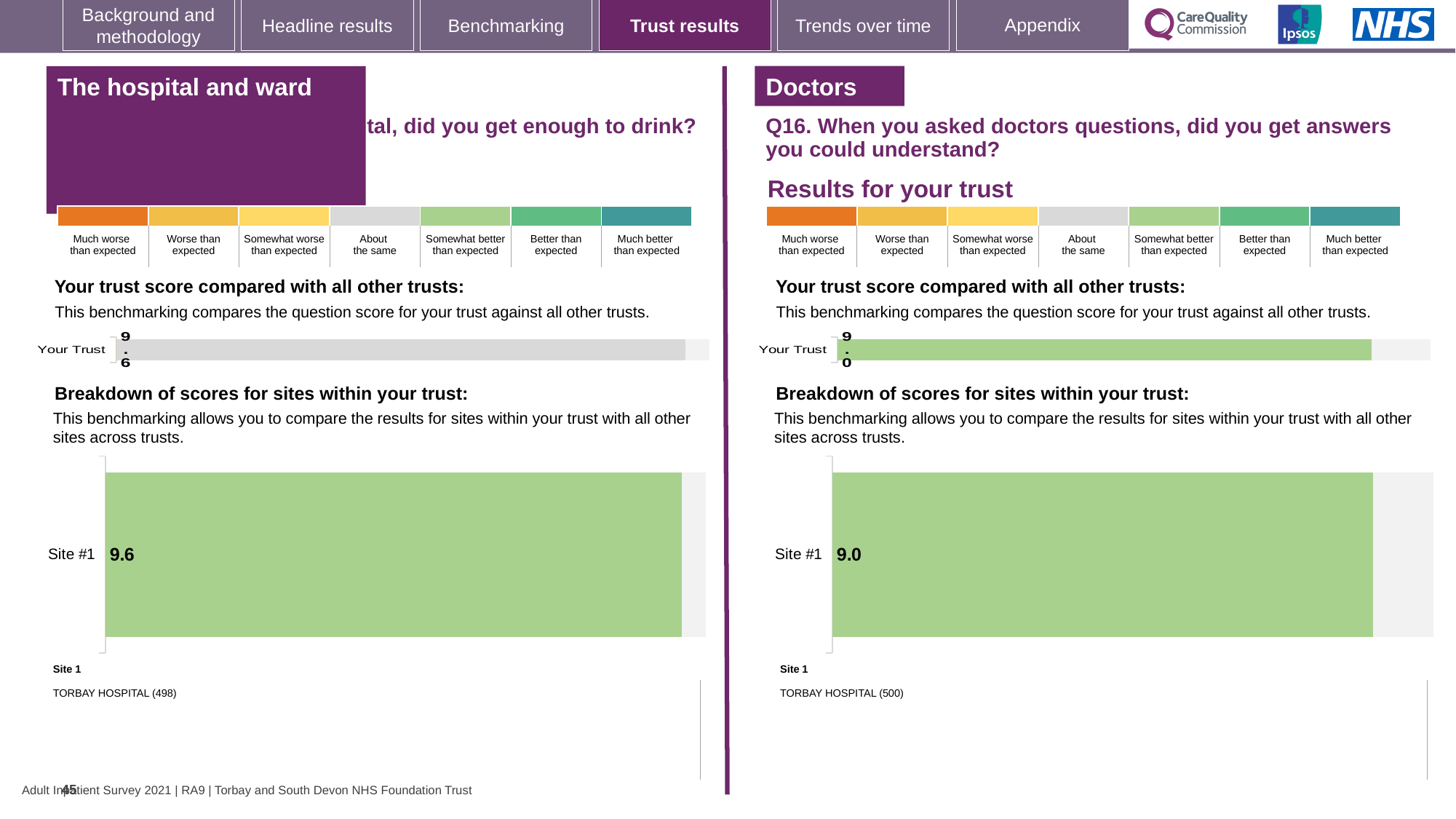
What is the difference between the Site #1 score on the left-hand site breakdown chart and the Site #1 score on the right-hand site breakdown chart? 0.6 On the left-hand 'Breakdown of scores for sites within your trust' chart, what is the score for Site #1? 9.6 On the right-hand 'Breakdown of scores for sites within your trust' chart (Q16), what is the score for Site #1? 9.0 What kind of chart is used to show the Site #1 score on the left-hand side of the slide? Bar chart Which site name is listed under the left-hand site breakdown chart for Site 1? TORBAY HOSPITAL (498) What colour is the Your Trust bar on the left-hand 'Your trust score compared with all other trusts' chart? Grey On the right-hand 'Your trust score compared with all other trusts' chart (Q16), what is the score for Your Trust? 9.0 Which site name is listed under the right-hand site breakdown chart for Site 1? TORBAY HOSPITAL (500) Which is larger: the Site #1 score on the left-hand site breakdown chart or the Site #1 score on the right-hand site breakdown chart? Left-hand (9.6) How many sites are shown on the right-hand 'Breakdown of scores for sites within your trust' chart? 1 What colour is the Site #1 bar on the right-hand 'Breakdown of scores for sites within your trust' chart? Green On the left-hand 'Your trust score compared with all other trusts' chart, what is the score for Your Trust? 9.6